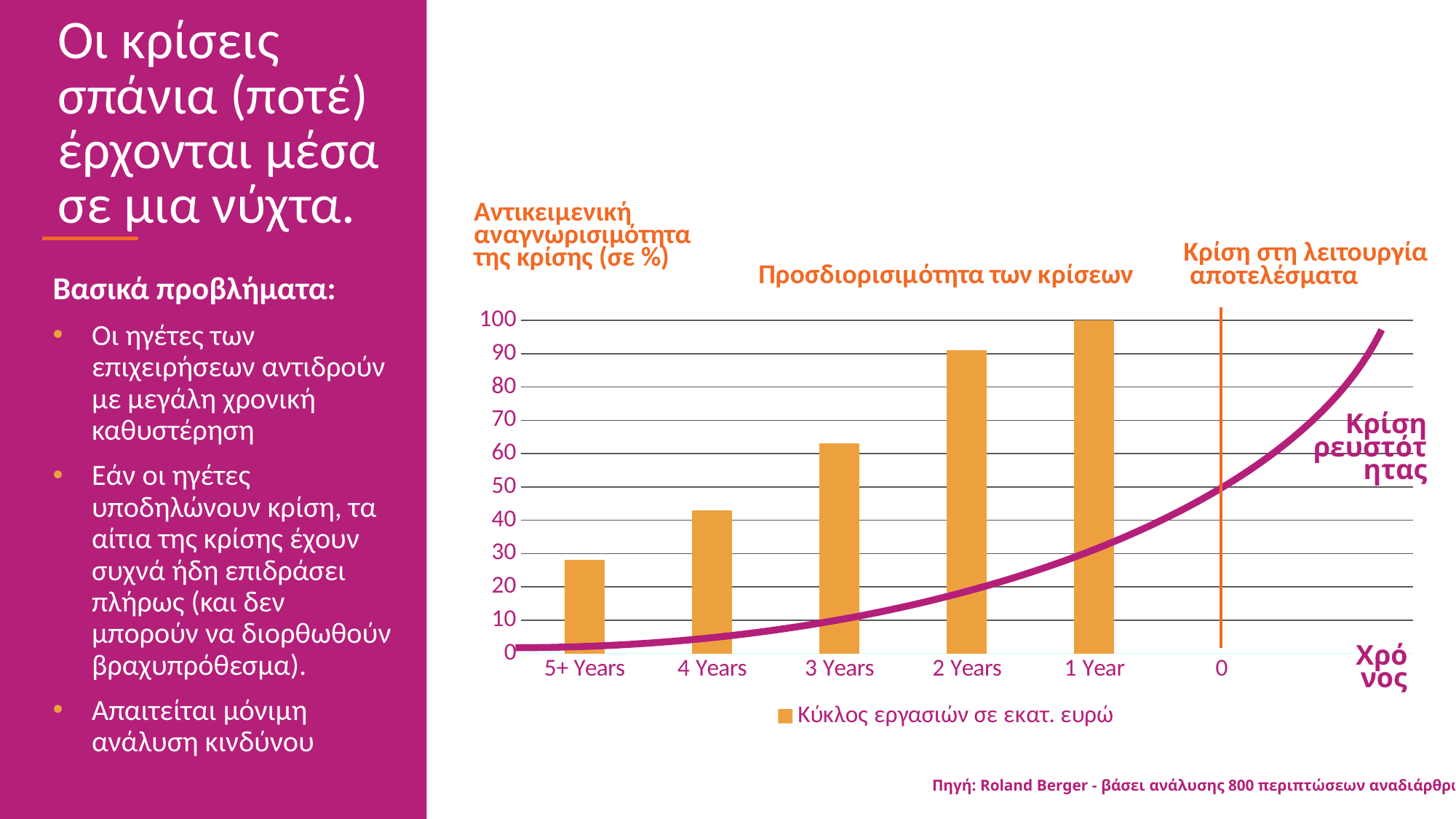
How many series does the legend list? 1 Is the value for 5+ Years greater or less than 30? less Is the value for 4 Years greater or less than 40? greater Which category has the tallest bar? 1 Year Which category with a bar has the shortest bar? 5+ Years Do the bar values rise or fall from 5+ Years to 1 Year along the x axis? rise What is the value of the bar for 1 Year? 100 What is the legend entry for the bars? Κύκλος εργασιών σε εκατ. ευρώ What kind of chart is shown on the slide? bar chart Is the value for 3 Years greater or less than 60? greater Which is larger, the bar for 3 Years or the bar for 4 Years? 3 Years